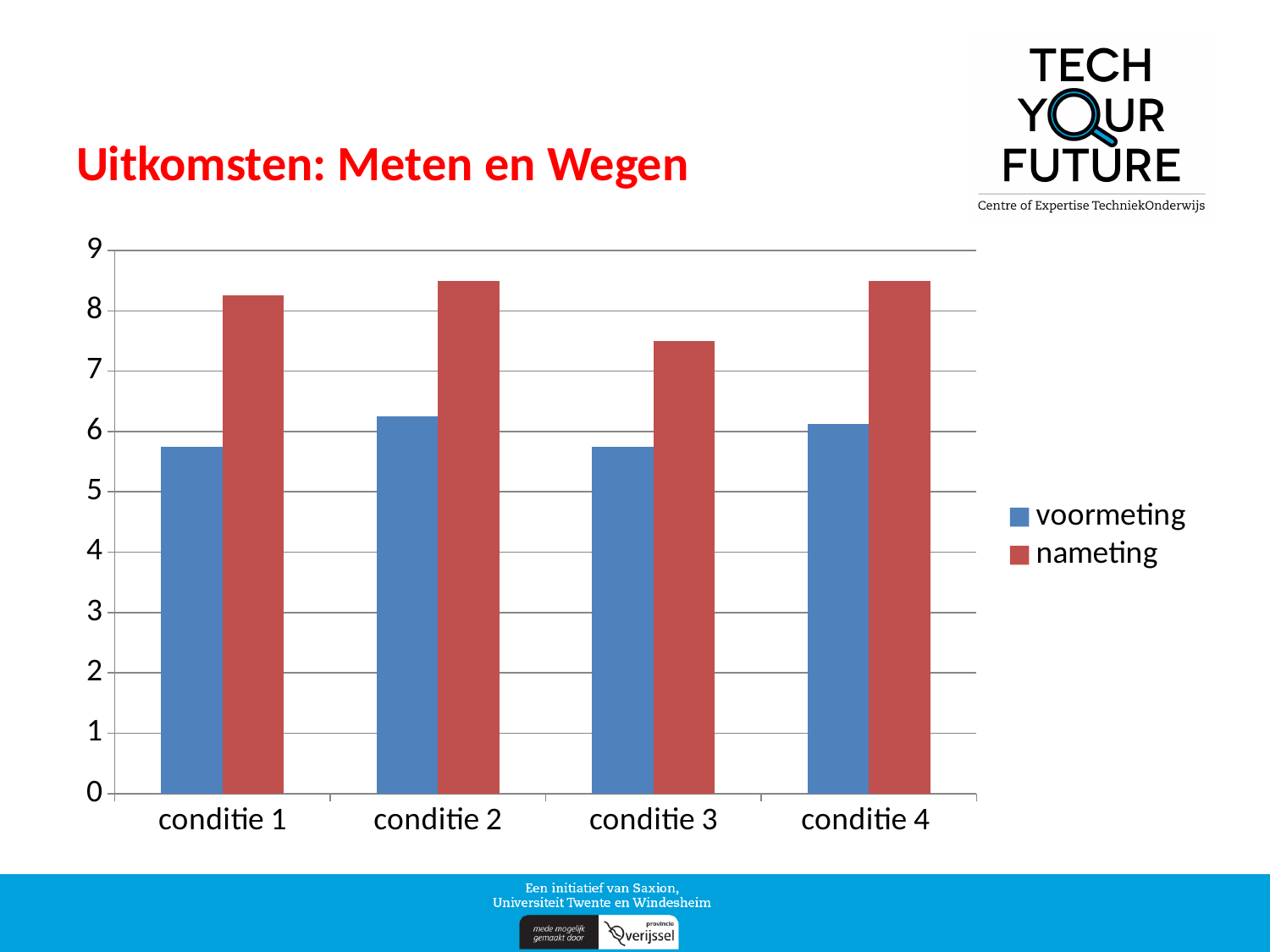
What is the title of the slide containing the chart? Uitkomsten: Meten en Wegen Is the nameting value for conditie 3 greater or less than 8? less For conditie 1, which is larger: voormeting or nameting? nameting Is the voormeting value for conditie 1 greater or less than 6? less How many series does the legend list? 2 Which is larger: the voormeting value for conditie 2 or the voormeting value for conditie 1? conditie 2 What kind of chart is shown on the slide? bar chart Which conditie has the lowest nameting value? conditie 3 Which is larger: the nameting value for conditie 1 or the nameting value for conditie 3? conditie 1 Is the voormeting value for conditie 2 greater or less than 6? greater How many categories (condities) are shown on the x axis? 4 What are the two series named in the legend? voormeting and nameting